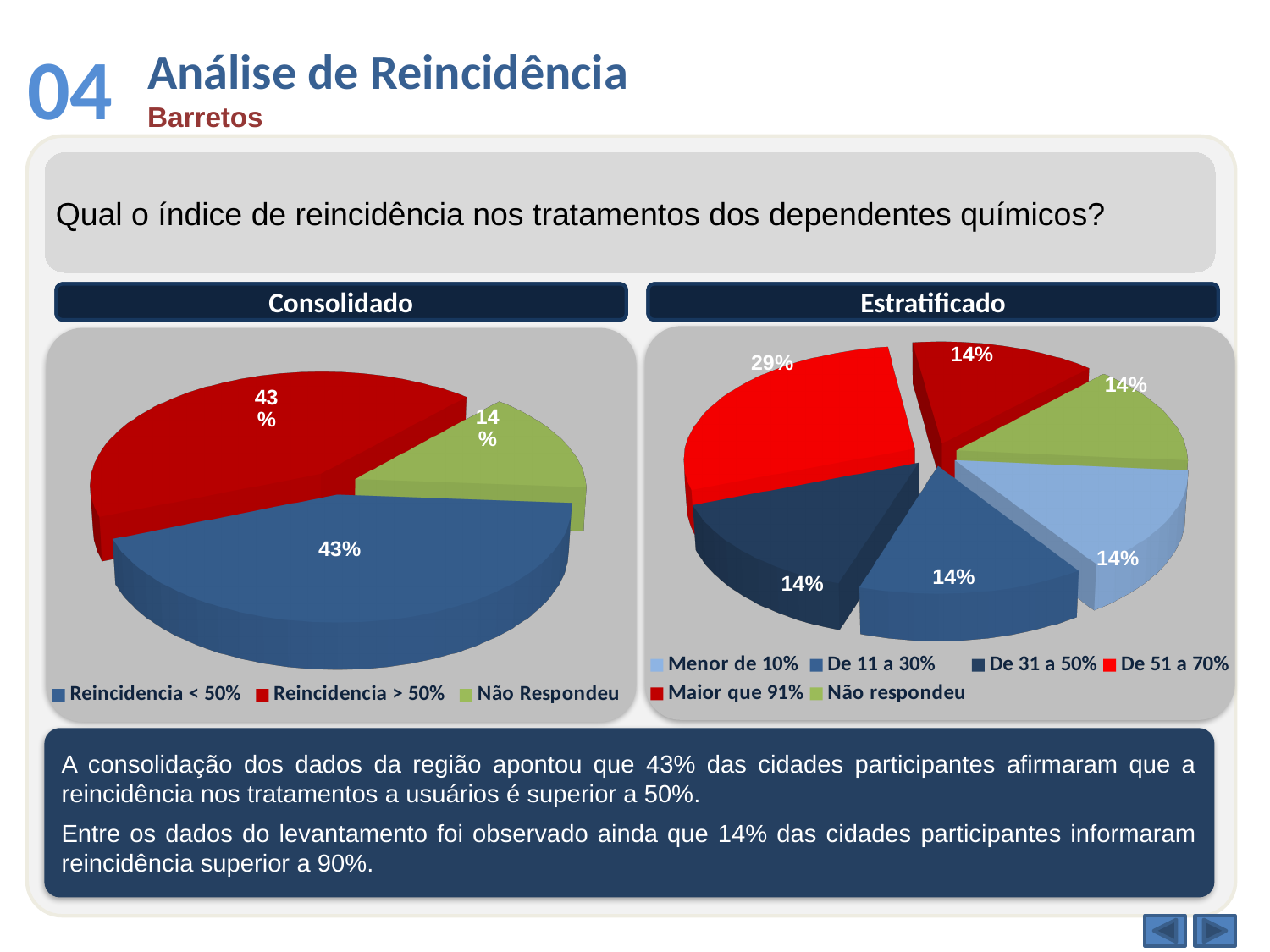
In the Estratificado chart, what share is labelled for De 51 a 70%? 29% In the Estratificado chart, what share is labelled for Maior que 91%? 14% In the Estratificado chart, which category has the largest slice? De 51 a 70% In the Consolidado chart, what share is labelled for Não Respondeu? 14% In the Estratificado chart, which is larger: De 51 a 70% or De 31 a 50%? De 51 a 70% In the Estratificado chart, what is the difference between the De 51 a 70% slice and the Menor de 10% slice? 15% In the Consolidado chart, what share is labelled for Reincidencia > 50%? 43% In the Consolidado chart, how many categories does the legend list? 3 In the Consolidado chart, what colour is the Reincidencia < 50% slice? Blue In the Estratificado chart, how many categories does the legend list? 6 What type of chart is the Consolidado chart? Pie chart In the Consolidado chart, which category has the smallest slice? Não Respondeu